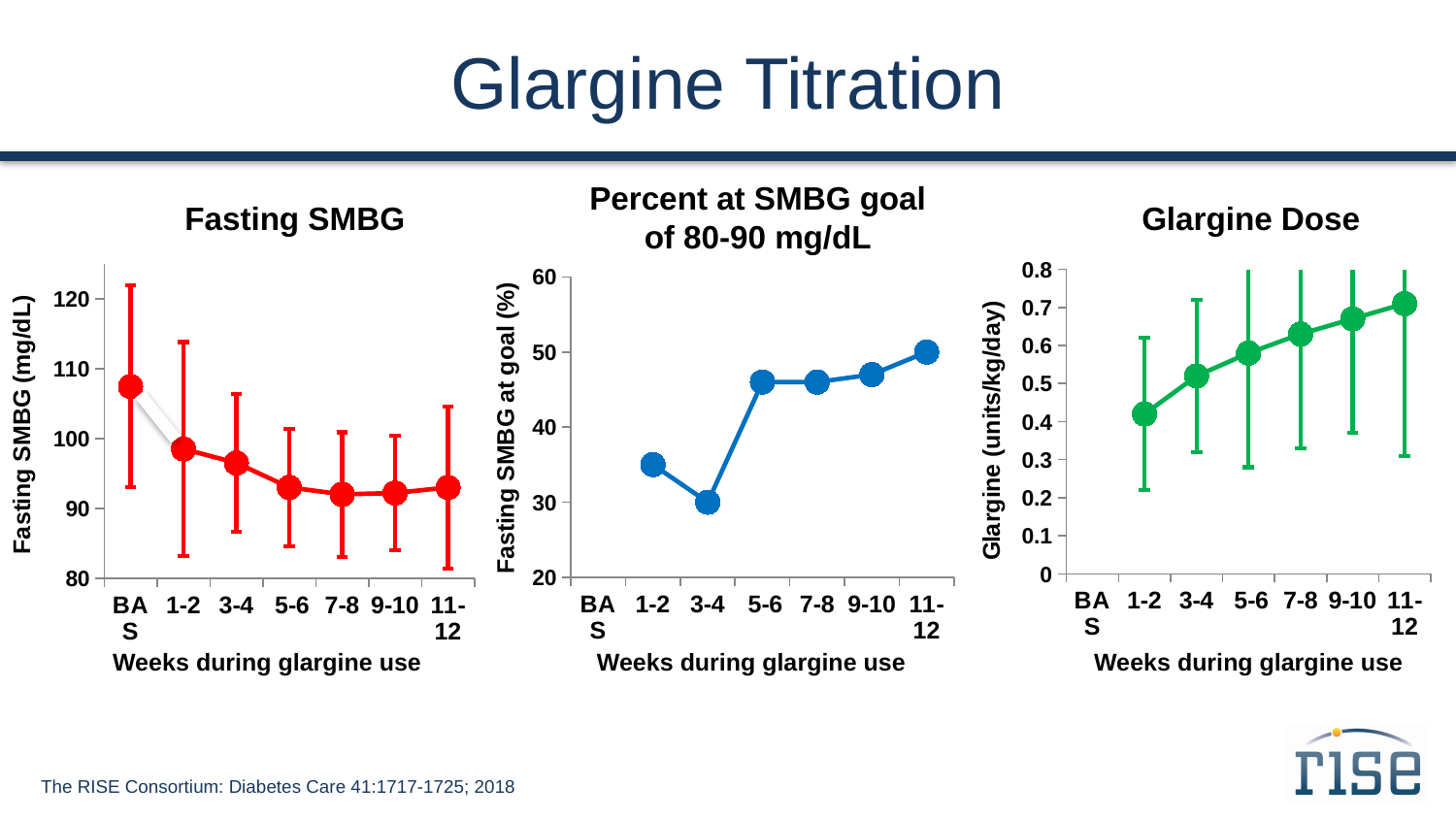
What kind of chart is the Glargine Dose chart? line chart In the Glargine Dose chart, do the values rise or fall from weeks 1-2 to weeks 11-12? rise In the Percent at SMBG goal of 80-90 mg/dL chart, is the value at weeks 1-2 greater or less than 40? less In the Fasting SMBG chart, which week category has the highest fasting SMBG value? BAS In the Glargine Dose chart, is the value at weeks 1-2 greater or less than 0.5? less In the Fasting SMBG chart, is the value at BAS greater or less than 100? greater In the Fasting SMBG chart, do the values generally rise or fall from BAS to weeks 11-12? fall In the Percent at SMBG goal of 80-90 mg/dL chart, how many data points are plotted? 6 In the Glargine Dose chart, which is larger, the value at weeks 1-2 or at weeks 11-12? 11-12 In the Percent at SMBG goal of 80-90 mg/dL chart, which week category has the highest percent at goal? 11-12 In the Percent at SMBG goal of 80-90 mg/dL chart, which week category has the lowest percent at goal? 3-4